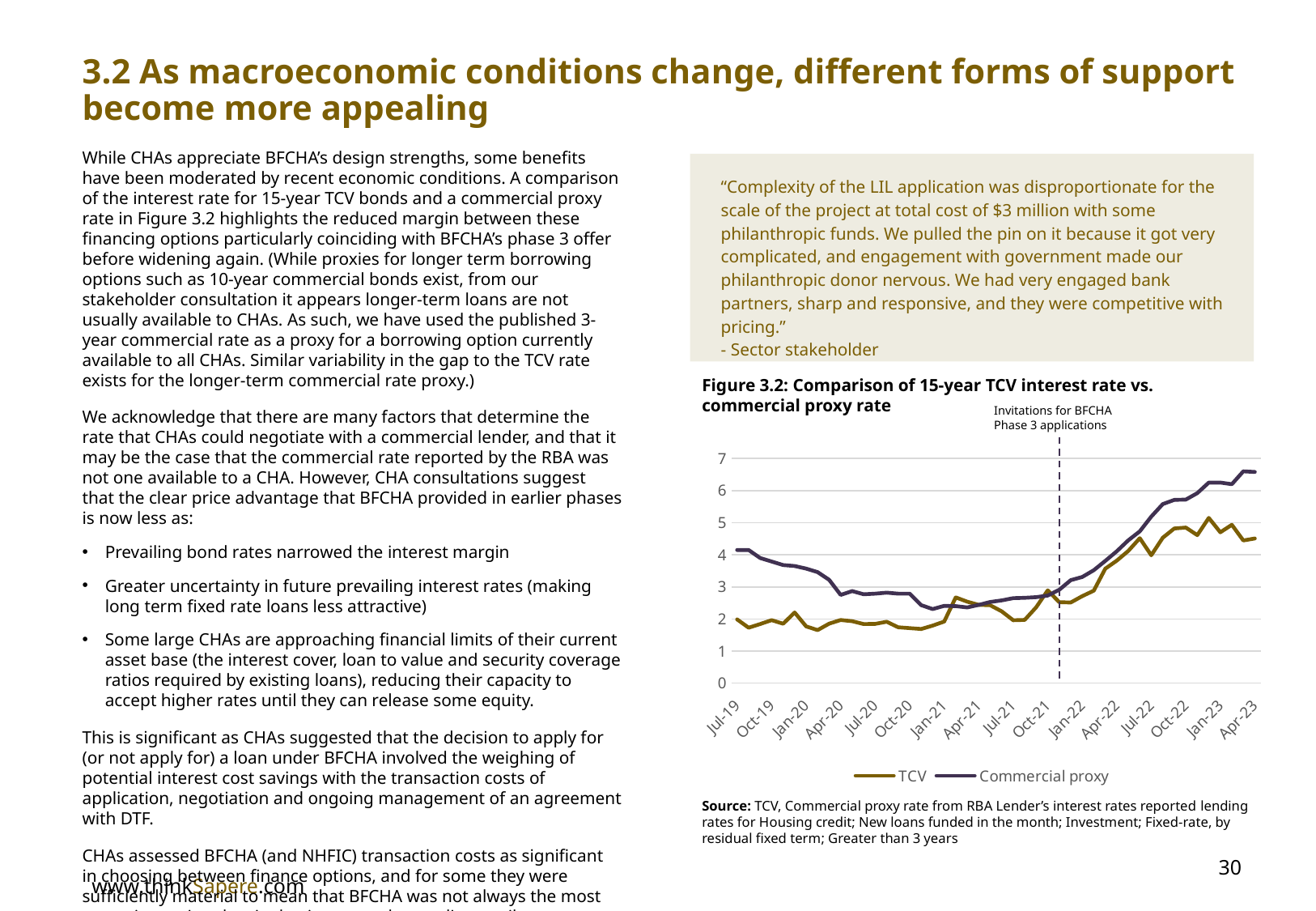
What kind of chart is Figure 3.2? Line chart What are the two series named in the legend of Figure 3.2? TCV and Commercial proxy Does the Commercial proxy line rise or fall between Jul-19 and Jan-21? Fall Is the Commercial proxy value at Oct-22 greater or less than 5? greater How many series does the legend of Figure 3.2 list? 2 Is the Commercial proxy value at Jan-21 greater or less than 3? less How many date labels are shown on the x axis of Figure 3.2? 16 What does the dashed vertical line in Figure 3.2 mark? Invitations for BFCHA Phase 3 applications Is the Commercial proxy value at Apr-23 greater or less than 6? greater At Jul-19, which series has the higher value, TCV or Commercial proxy? Commercial proxy Does the TCV line rise or fall between Jan-22 and Jul-22? Rise